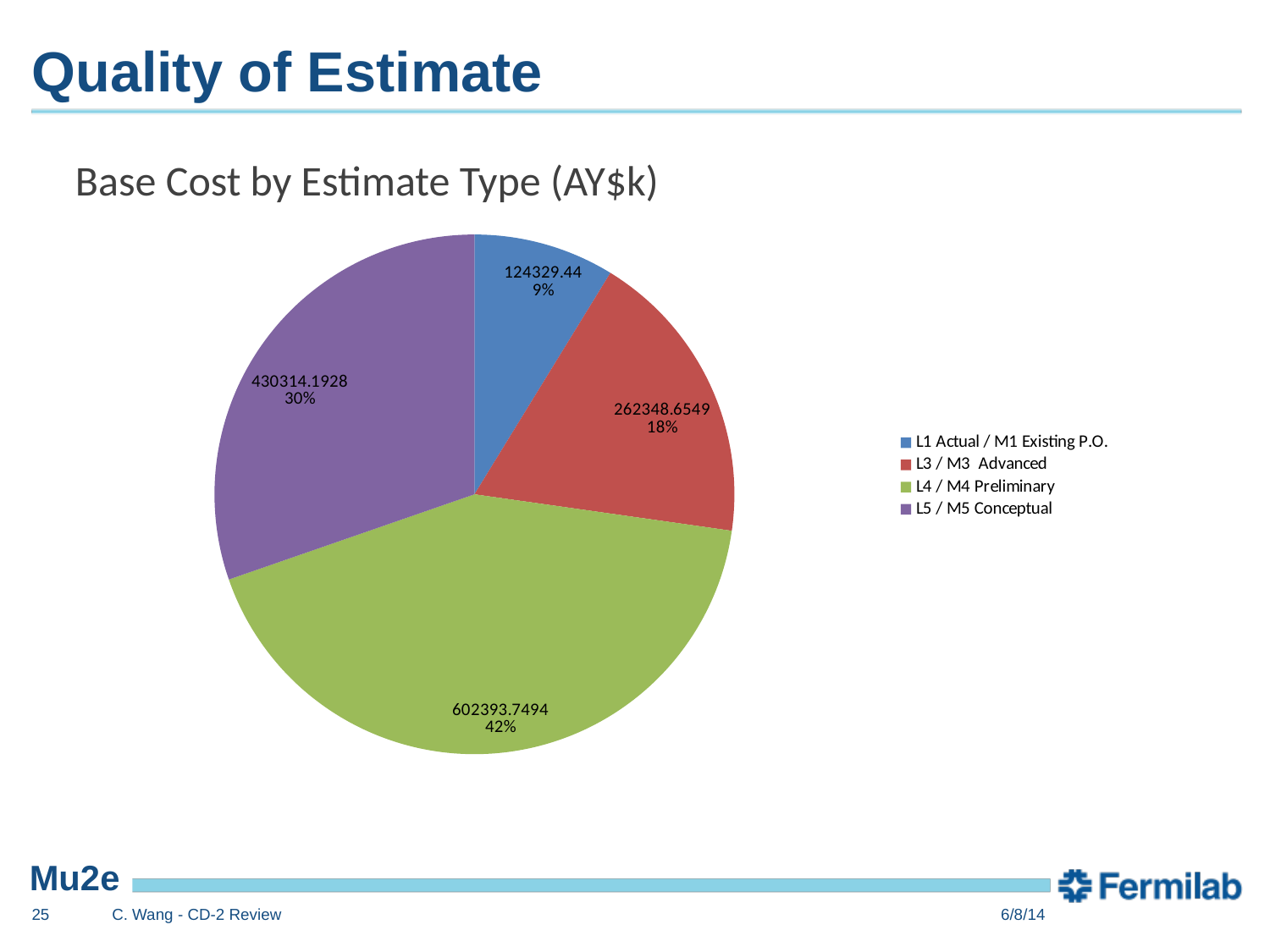
What type of chart is shown on the slide? Pie chart Which estimate type has the largest base cost? L4 / M4 Preliminary How many slices does the pie chart have? 4 How many entries does the legend list? 4 What share of the pie does L5 / M5 Conceptual represent? 30% What is the value for L4 / M4 Preliminary? 602393.7494 What is the value for L5 / M5 Conceptual? 430314.1928 What share of the pie does L3 / M3 Advanced represent? 18% What is the title of the chart? Base Cost by Estimate Type (AY$k) Which is larger, the base cost for L5 / M5 Conceptual or for L3 / M3 Advanced? L5 / M5 Conceptual Which estimate type has the smallest base cost? L1 Actual / M1 Existing P.O. What is the value for L1 Actual / M1 Existing P.O.? 124329.44